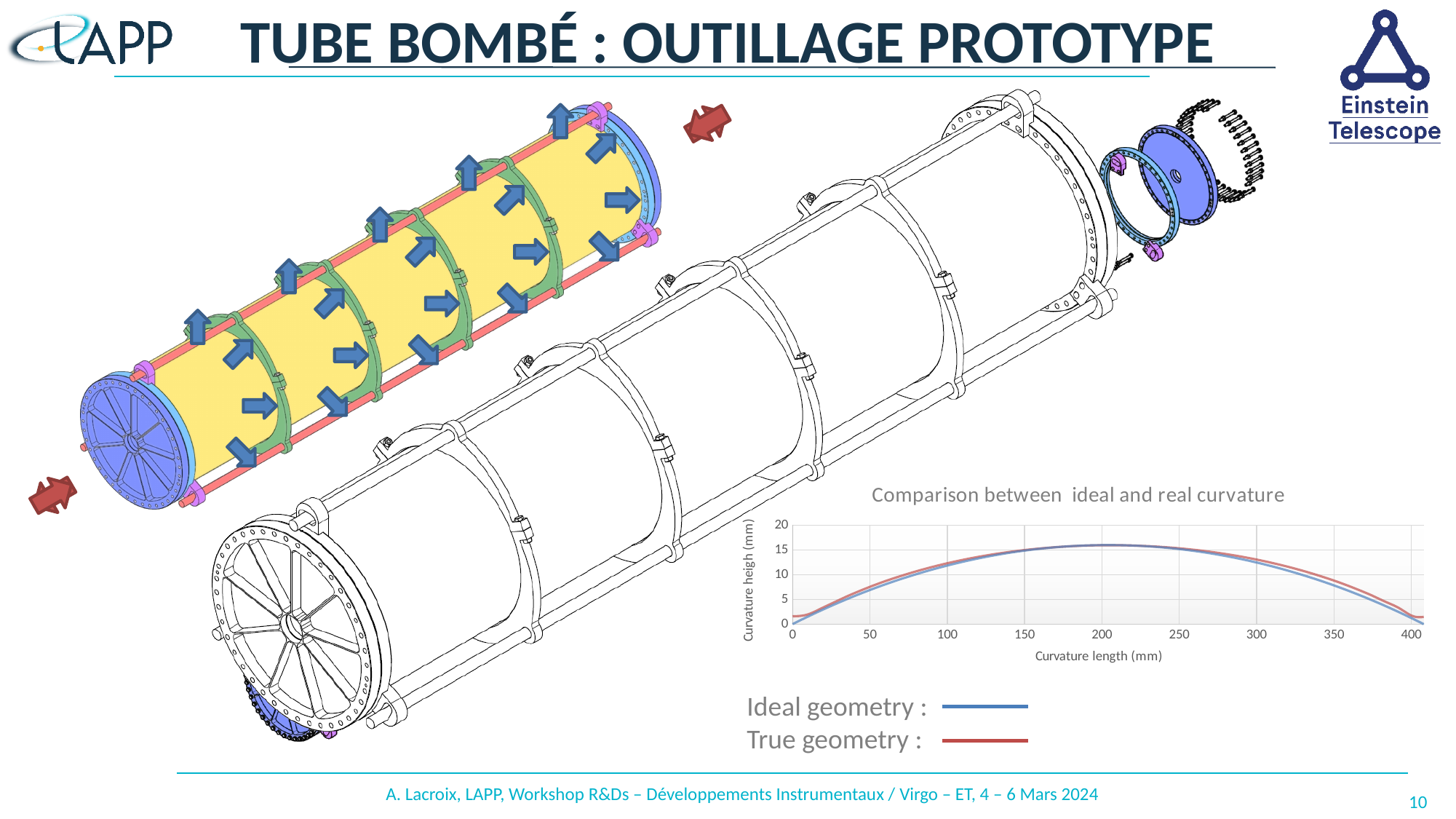
Is the Ideal geometry curvature height at a curvature length of 200 mm greater or less than 10? greater What is the title of the chart on the slide? Comparison between ideal and real curvature Which series in the curvature chart is drawn in red? True geometry What is the label of the y axis of the curvature chart? Curvature heigh (mm) Is the True geometry curvature height at a curvature length of 400 mm greater or less than 5? less What is the highest tick value shown on the x axis of the curvature chart? 400 What is the highest tick value shown on the y axis of the curvature chart? 20 How many series does the legend of the curvature chart list? 2 How does the curvature height change along the x axis from 0 to 400 mm? rises then falls Is the Ideal geometry curvature height at a curvature length of 50 mm greater or less than 10? less What is the label of the x axis of the curvature chart? Curvature length (mm) What kind of chart is shown on the slide? line chart